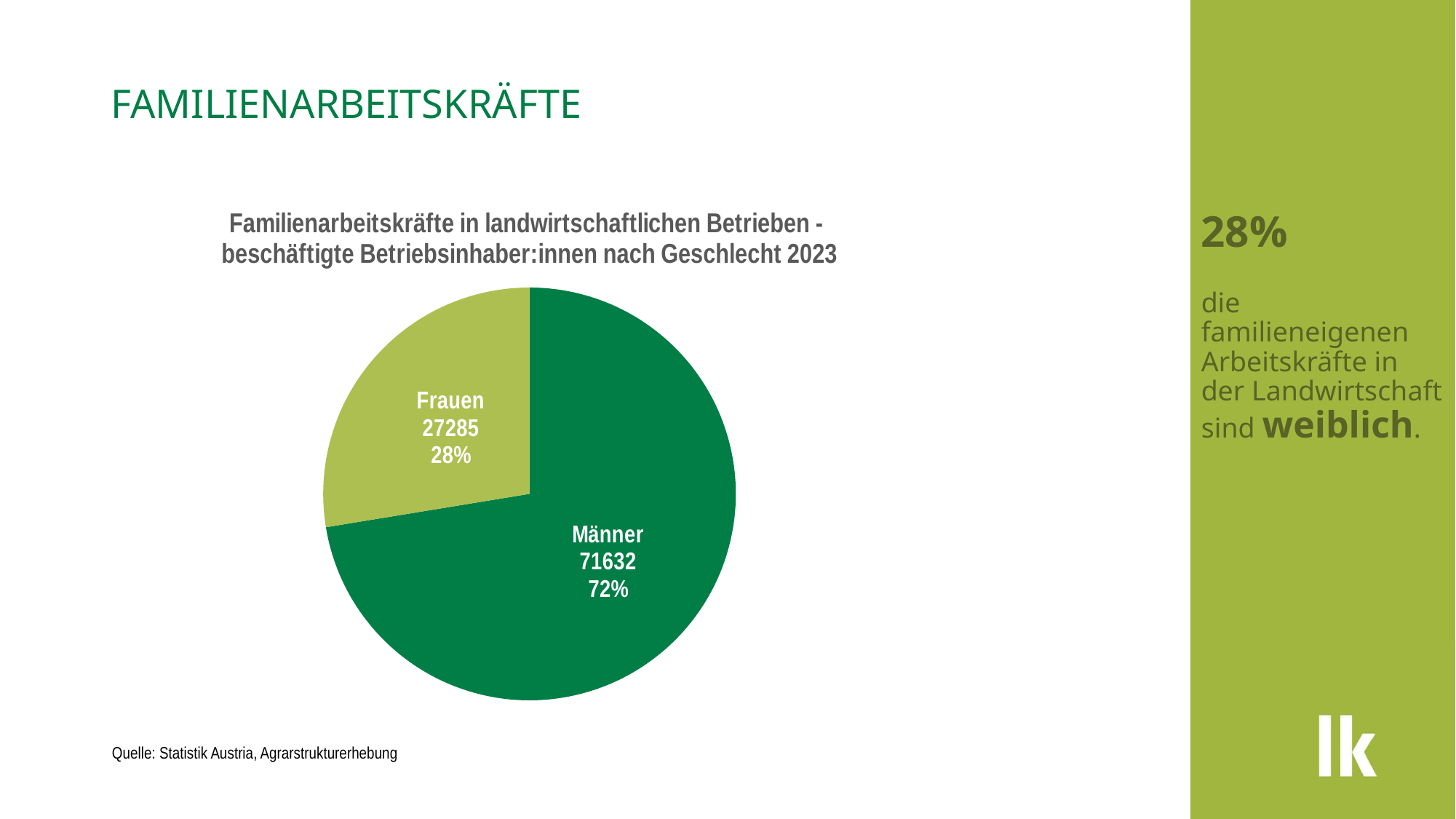
What kind of chart is shown on the slide? pie chart Which is larger, the value for Frauen or the value for Männer? Männer How many slices does the pie chart have? 2 What share of the pie does the Männer slice represent? 72% What is the total of the two slices in the pie chart? 98917 Which category has the largest slice? Männer What is the title of the chart? Familienarbeitskräfte in landwirtschaftlichen Betrieben - beschäftigte Betriebsinhaber:innen nach Geschlecht 2023 What is the value for Frauen? 27285 Which category has the smallest slice? Frauen What is the difference between the values for Männer and Frauen? 44347 What is the value for Männer? 71632 What share of the pie does the Frauen slice represent? 28%